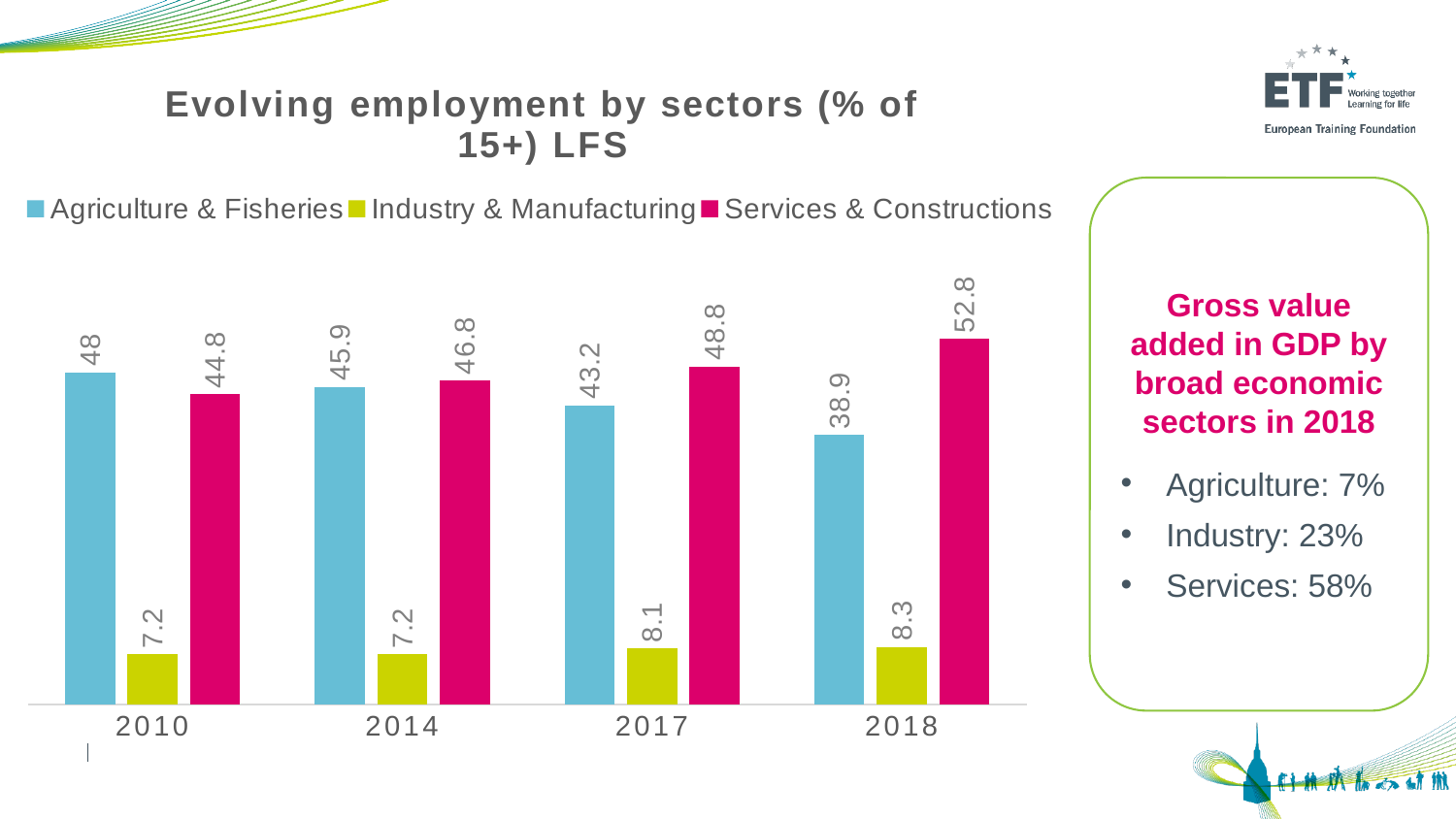
Which is larger in 2010: Agriculture & Fisheries or Services & Constructions? Agriculture & Fisheries What is the difference between Services & Constructions and Agriculture & Fisheries in 2018? 13.9 What is the value for Agriculture & Fisheries in 2010? 48 What kind of chart is shown? Bar chart What is the value for Industry & Manufacturing in 2017? 8.1 Does the Agriculture & Fisheries value rise or fall from 2010 to 2018? Fall What is the title of the chart? Evolving employment by sectors (% of 15+) LFS How many series does the legend list? 3 In which year is the Services & Constructions value highest? 2018 How many years are shown on the x axis? 4 In which year is the Agriculture & Fisheries value lowest? 2018 What is the value for Services & Constructions in 2018? 52.8